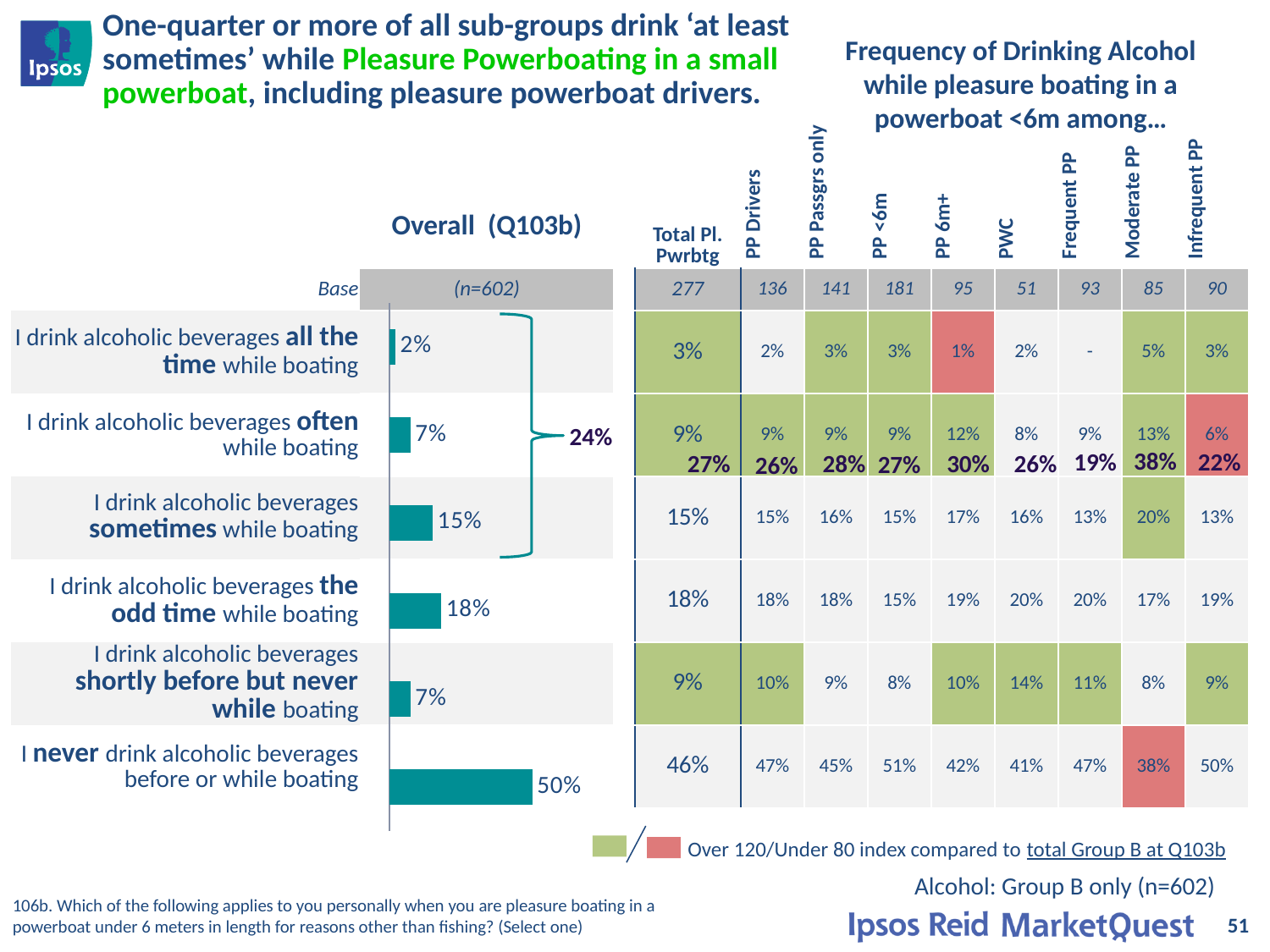
What type of chart is the Overall (Q103b) chart? bar chart In the Overall (Q103b) bar chart, what is the difference between the 'never' category and the 'the odd time' category? 32% In the Overall (Q103b) bar chart, what percentage say they drink alcoholic beverages all the time while boating? 2% What is the base size (n) shown for the Overall (Q103b) bar chart? (n=602) In the Overall (Q103b) bar chart, which category has the highest value? I never drink alcoholic beverages before or while boating In the Overall (Q103b) bar chart, what percentage say they drink alcoholic beverages the odd time while boating? 18% In the Overall (Q103b) bar chart, what percentage of respondents say they never drink alcoholic beverages before or while boating? 50% How many categories are shown in the Overall (Q103b) bar chart? 6 In the Overall (Q103b) bar chart, what percentage say they drink alcoholic beverages sometimes while boating? 15% In the Overall (Q103b) bar chart, which category has the lowest value? I drink alcoholic beverages all the time while boating In the Overall (Q103b) bar chart, what combined percentage is shown by the bracket grouping the 'all the time', 'often' and 'sometimes' categories? 24% In the Overall (Q103b) bar chart, which is larger: 'sometimes while boating' or 'often while boating'? sometimes while boating